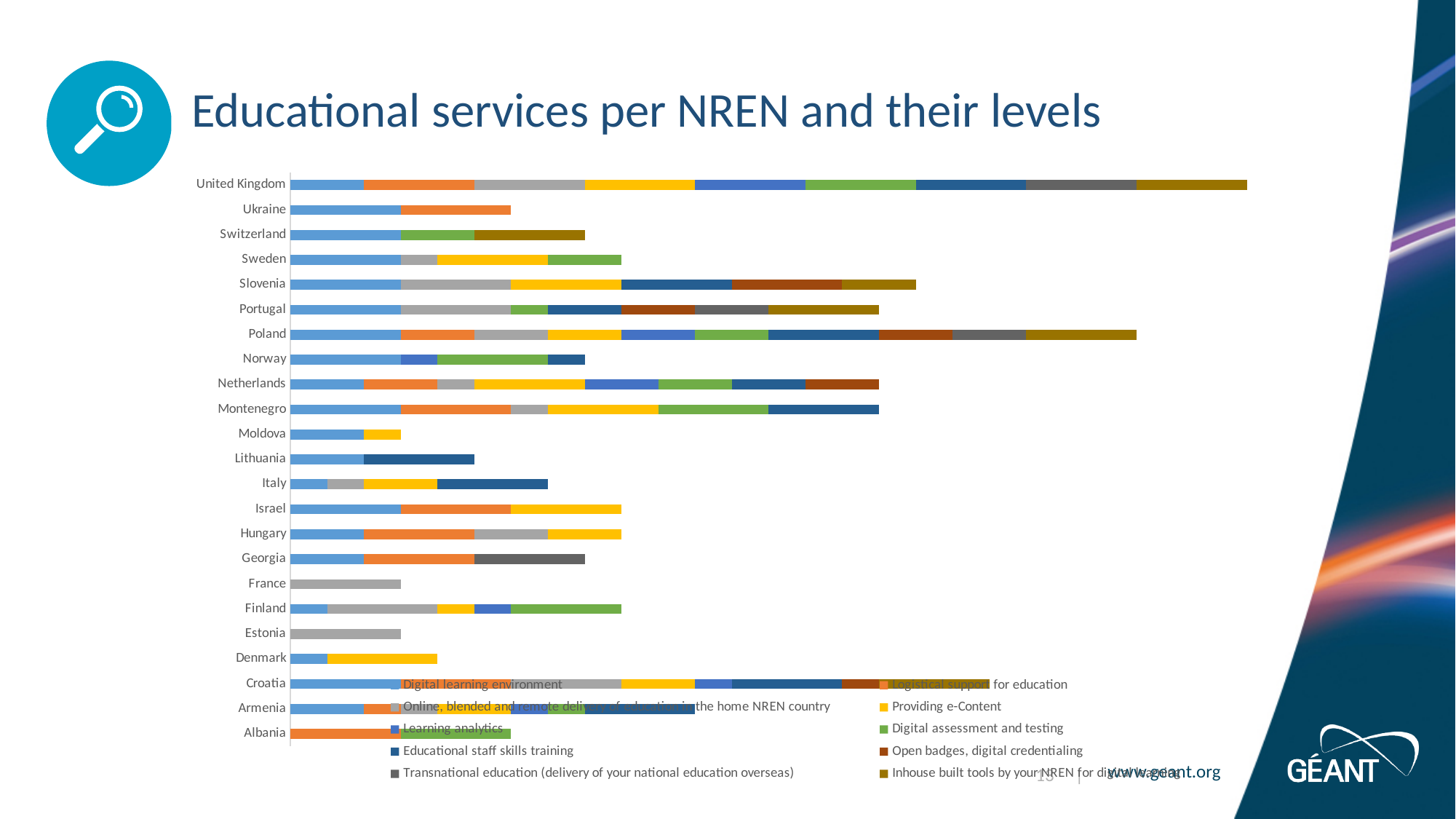
Which country has the longest overall bar in the chart? United Kingdom Which single service does the bar for Estonia consist of? Online, blended and remote delivery of education in the home NREN country What is the title of the chart on the slide? Educational services per NREN and their levels How many segments make up the bar for Moldova? 2 Which bar is longer overall, Netherlands or Norway? Netherlands How many series does the chart's legend list? 10 How many segments make up the bar for France? 1 Which bar is longer overall, Slovenia or Ukraine? Slovenia What kind of chart is shown on the slide? Stacked bar chart How many countries (NRENs) are listed on the vertical axis of the chart? 23 Which country's bar contains segments for all 10 services in the legend? Poland